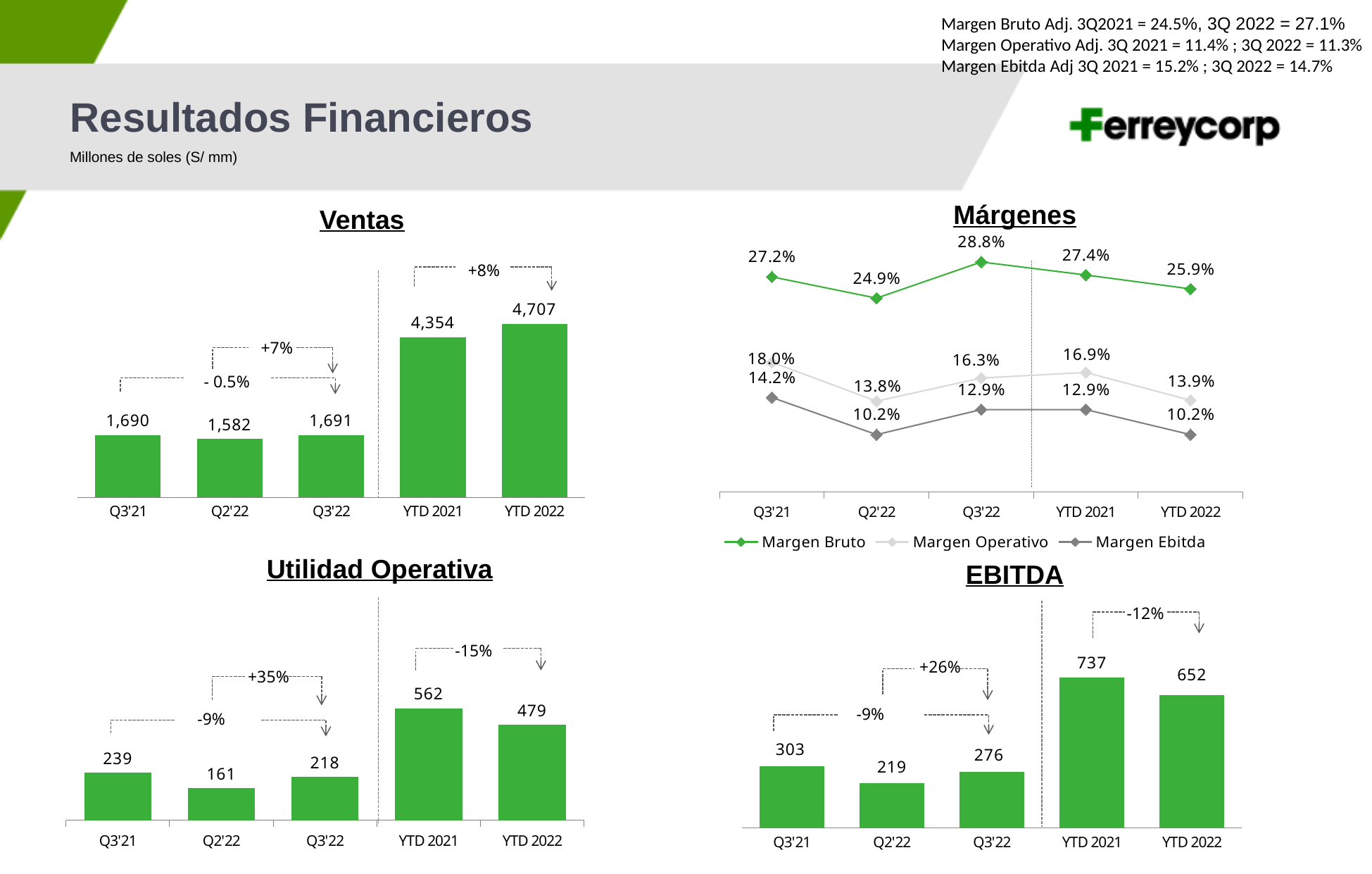
In the Ventas chart, which category has the lowest value? Q2'22 In the Ventas chart, what is the value for YTD 2022? 4,707 In the Márgenes chart, what is the Margen Bruto value for Q3'22? 28.8% In the Utilidad Operativa chart, which is larger, YTD 2021 or YTD 2022? YTD 2021 In the Márgenes chart, what is the Margen Ebitda value for YTD 2022? 10.2% How many categories are shown on the x axis of the Utilidad Operativa chart? 5 In the Márgenes chart, how many series does the legend list? 3 In the Ventas chart, what is the difference between YTD 2022 and YTD 2021? 353 In the EBITDA chart, what is the value for Q2'22? 219 In the Utilidad Operativa chart, what is the value for Q3'22? 218 In the EBITDA chart, what is the difference between Q3'21 and Q3'22? 27 What kind of chart is the EBITDA chart? Bar chart